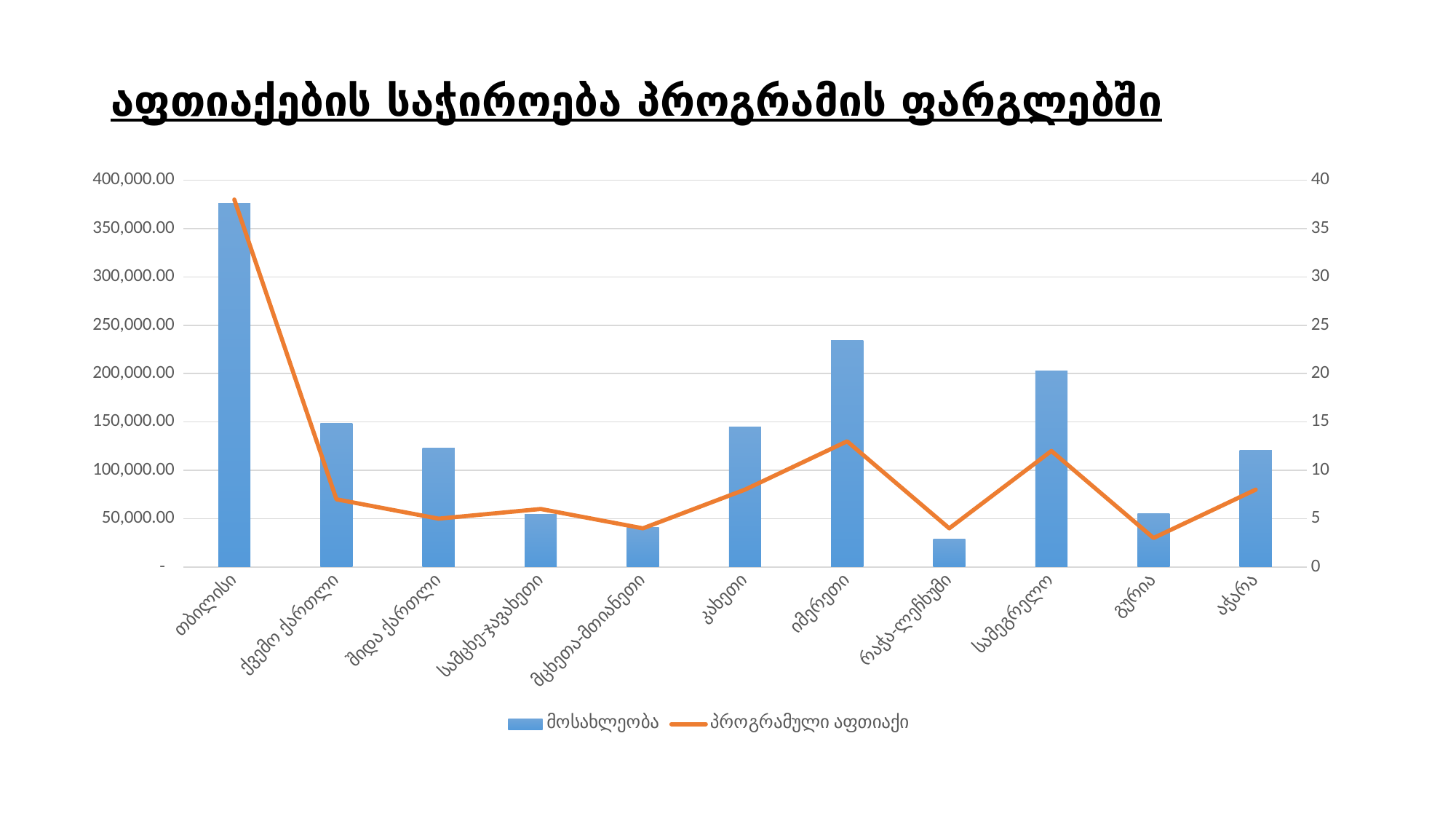
Which series is drawn as an orange line? პროგრამული აფთიაქი Which category has the lowest მოსახლეობა bar? რაჭა-ლეჩხუმი How many categories are shown along the x axis? 11 What kind of chart is shown on the slide? A combined bar and line chart Is the მოსახლეობა value for თბილისი greater or less than 350,000.00? greater Is the მოსახლეობა value for მცხეთა-მთიანეთი greater or less than 50,000.00? less Which category has the highest მოსახლეობა bar? თბილისი Which has the larger მოსახლეობა bar, იმერეთი or სამეგრელო? იმერეთი How many series does the legend list? 2 Is the მოსახლეობა value for იმერეთი greater or less than 200,000.00? greater Which category has the highest value on the პროგრამული აფთიაქი line? თბილისი